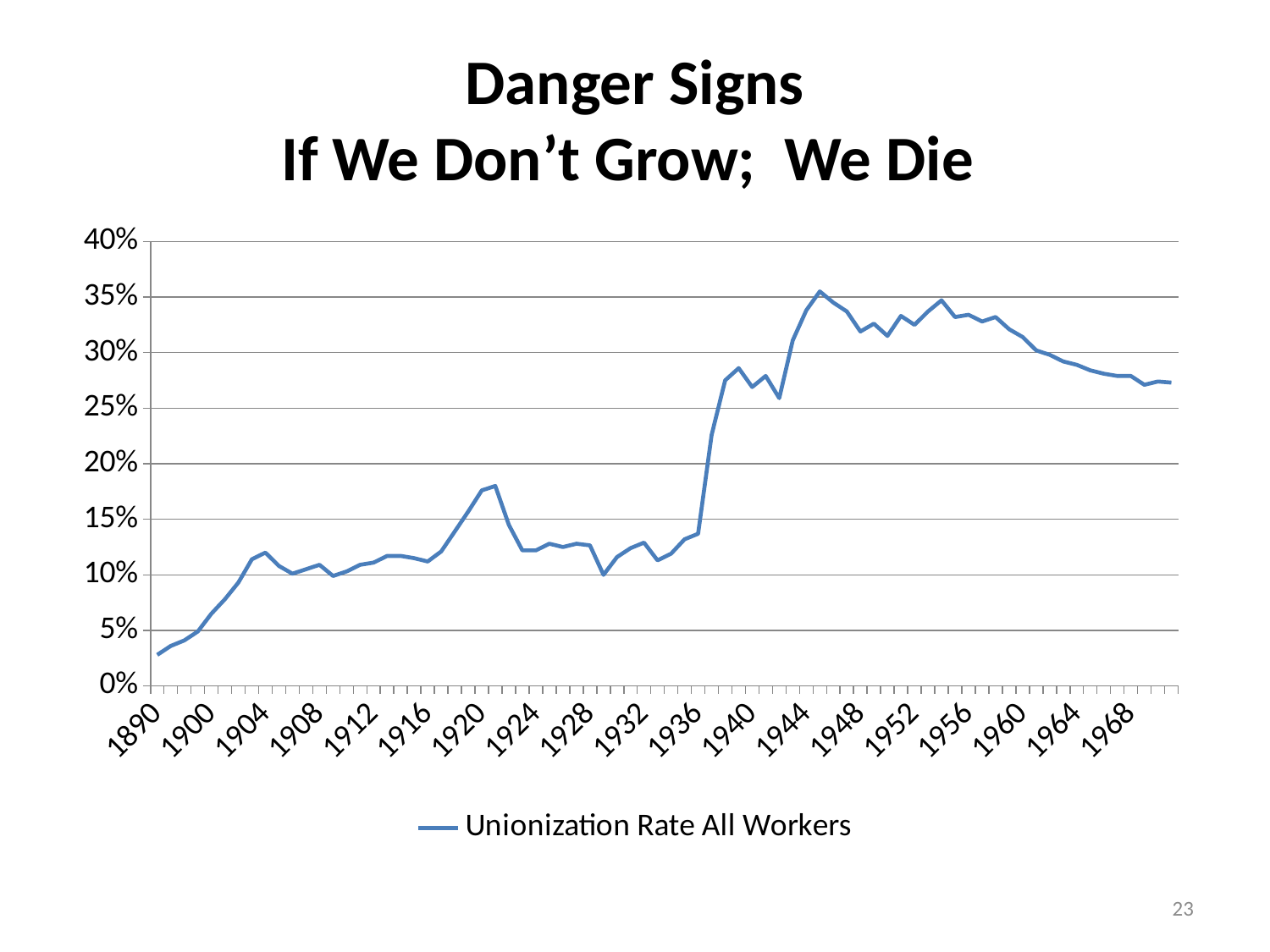
Do the values rise or fall between 1960 and 1968? fall What kind of chart is shown on the slide? line chart Which year on the x axis has the lowest unionization rate? 1890 Is the value for 1920 greater or less than 15%? greater Is the value for 1940 greater or less than 25%? greater Is the value for 1968 greater or less than 30%? less How many series does the legend list? 1 Do the values rise or fall between 1890 and 1904? rise What is the name of the series shown in the legend? Unionization Rate All Workers Which is larger, the value for 1920 or the value for 1940? 1940